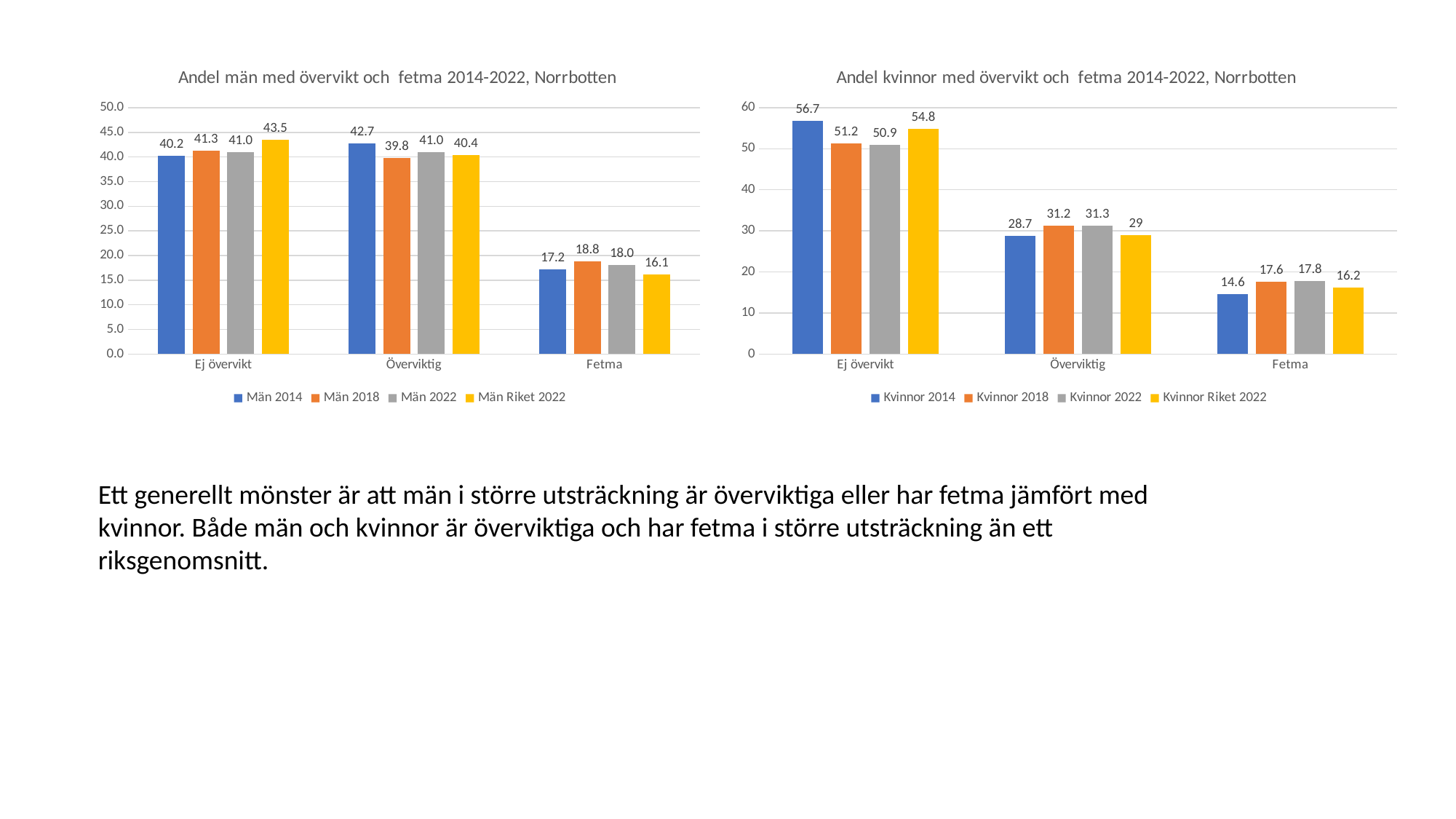
How many series does the legend of the chart 'Andel kvinnor med övervikt och fetma 2014-2022, Norrbotten' list? 4 In the chart 'Andel kvinnor med övervikt och fetma 2014-2022, Norrbotten', what colour are the Kvinnor Riket 2022 bars? Yellow In the chart 'Andel kvinnor med övervikt och fetma 2014-2022, Norrbotten', is the value for Kvinnor 2018 in the Överviktig category greater or less than 30? greater In the chart 'Andel män med övervikt och fetma 2014-2022, Norrbotten', which series has the highest value in the Fetma category? Män 2018 What kind of chart is the chart 'Andel män med övervikt och fetma 2014-2022, Norrbotten'? Bar chart How many categories are shown on the x axis of the chart 'Andel män med övervikt och fetma 2014-2022, Norrbotten'? 3 In the chart 'Andel män med övervikt och fetma 2014-2022, Norrbotten', which is larger in the Överviktig category: Män 2022 or Män Riket 2022? Män 2022 In the chart 'Andel kvinnor med övervikt och fetma 2014-2022, Norrbotten', which series has the lowest value in the Fetma category? Kvinnor 2014 In the chart 'Andel män med övervikt och fetma 2014-2022, Norrbotten', what is the value for Män 2014 in the Överviktig category? 42.7 In the chart 'Andel kvinnor med övervikt och fetma 2014-2022, Norrbotten', what is the value for Kvinnor Riket 2022 in the Ej övervikt category? 54.8 In the chart 'Andel kvinnor med övervikt och fetma 2014-2022, Norrbotten', what is the difference between Kvinnor 2014 and Kvinnor Riket 2022 in the Ej övervikt category? 1.9 In the chart 'Andel män med övervikt och fetma 2014-2022, Norrbotten', what is the difference between Män 2018 and Män Riket 2022 in the Fetma category? 2.7